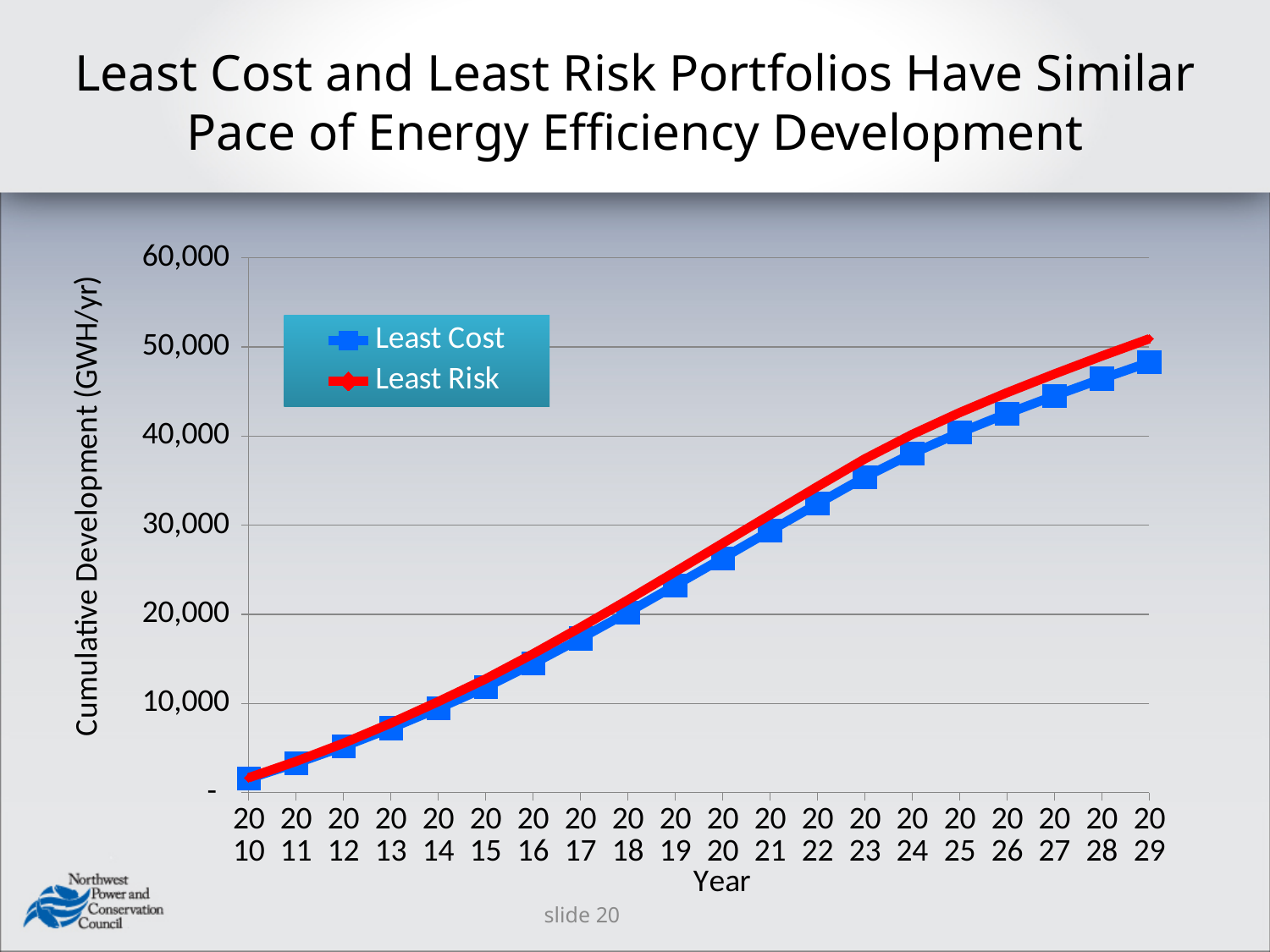
What kind of chart is shown on the slide? line chart Which series is drawn in red? Least Risk Is the Least Cost value for 2020 greater or less than 20,000? greater How many series does the legend list? 2 In 2029, which series has the higher value, Least Cost or Least Risk? Least Risk Is the Least Cost value for 2024 greater or less than 40,000? less Is the Least Risk value for 2013 greater or less than 10,000? less What is the label of the y axis? Cumulative Development (GWH/yr) How many years are shown along the x axis? 20 Do the Least Cost values rise or fall from 2010 to 2029? rise